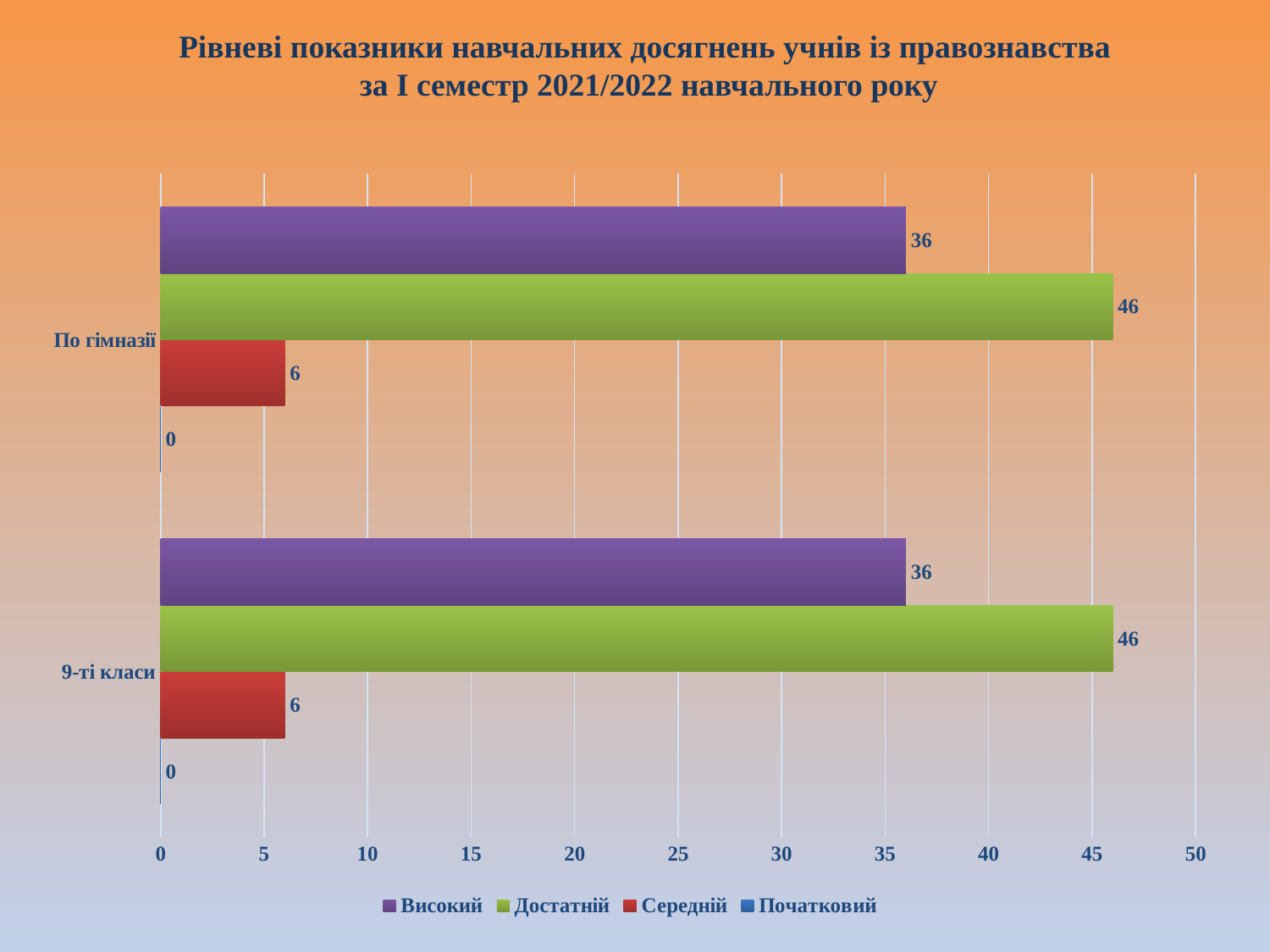
How many series does the legend list? 4 What is the difference between the Достатній and Високий values in the 9-ті класи category? 10 Which series has the lowest value in the 9-ті класи category? Початковий What is the value for Початковий in the 9-ті класи category? 0 What colour are the Достатній bars? Green What kind of chart is shown on the slide? Bar chart What is the value for Високий in the По гімназії category? 36 What is the value for Середній in the По гімназії category? 6 Which series has the highest value in the По гімназії category? Достатній Which is larger in the По гімназії category: Високий or Середній? Високий How many categories are shown on the vertical axis? 2 What is the value for Достатній in the 9-ті класи category? 46